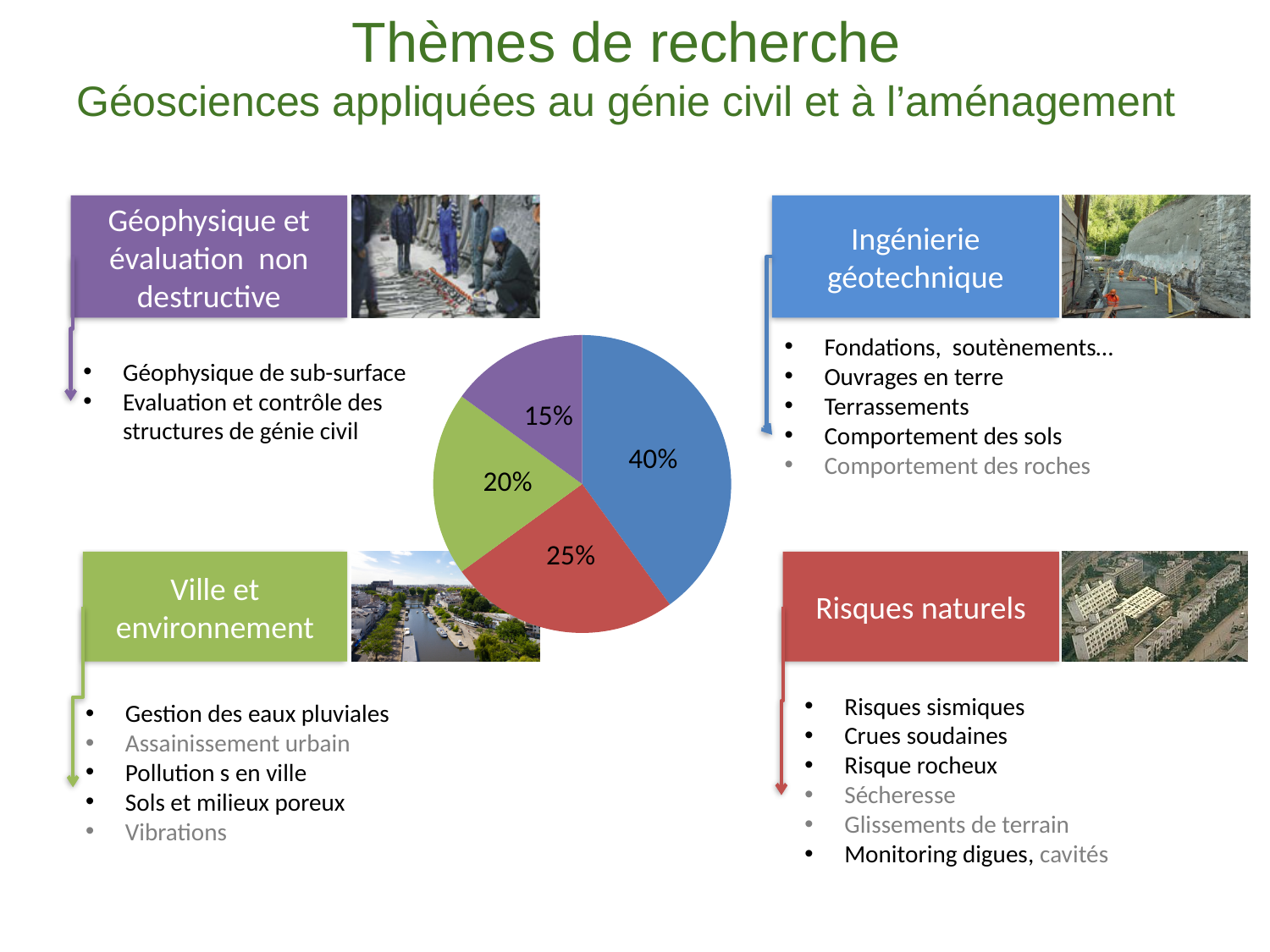
What do the four percentage labels on the pie chart add up to? 100% Which slice of the pie chart is the smallest? the purple slice (15%) What percentage is shown on the green slice of the pie chart? 20% How many slices does the pie chart have? 4 What kind of chart is shown in the centre of the slide? pie chart What percentage is shown on the purple slice of the pie chart? 15% Does the pie chart display a legend? No What percentage is shown on the blue slice of the pie chart? 40% What is the difference in percentage points between the largest and smallest slices of the pie chart? 25 Which slice is larger in the pie chart, the red one or the green one? the red one (25%) What percentage is shown on the red slice of the pie chart? 25% Which slice of the pie chart is the largest? the blue slice (40%)